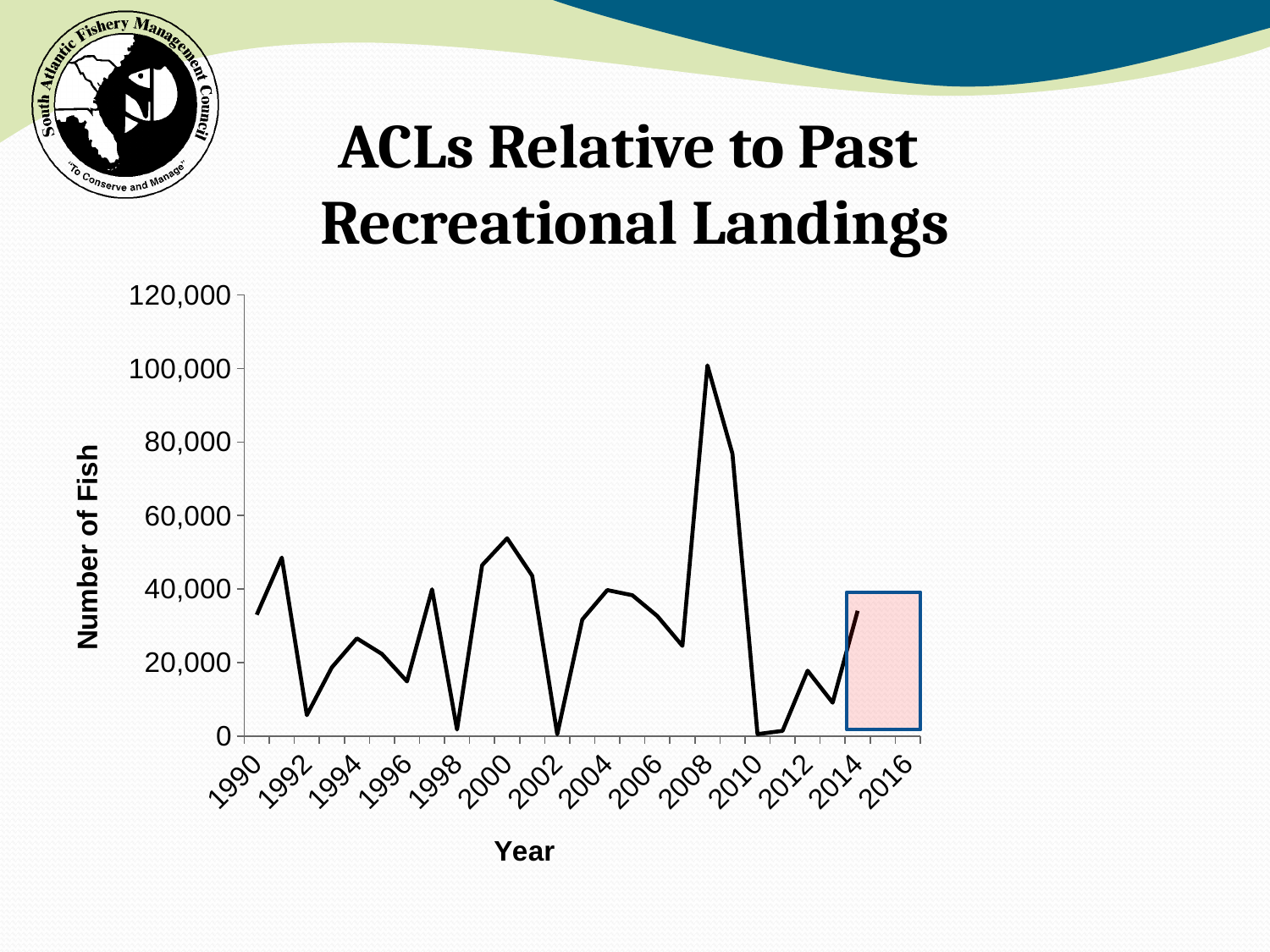
Is the value for 2000 greater or less than 40,000? greater Is the value for 2009 greater or less than 60,000? greater Which year has the larger value, 2008 or 2009? 2008 Which year has the larger value, 2000 or 1996? 2000 What kind of chart is shown on the slide? line chart In which year is the number of fish highest? 2008 Is the value for 1992 greater or less than 20,000? less What is the label of the horizontal axis? Year What is the label of the vertical axis? Number of Fish Do the values rise or fall from 2008 to 2010? fall